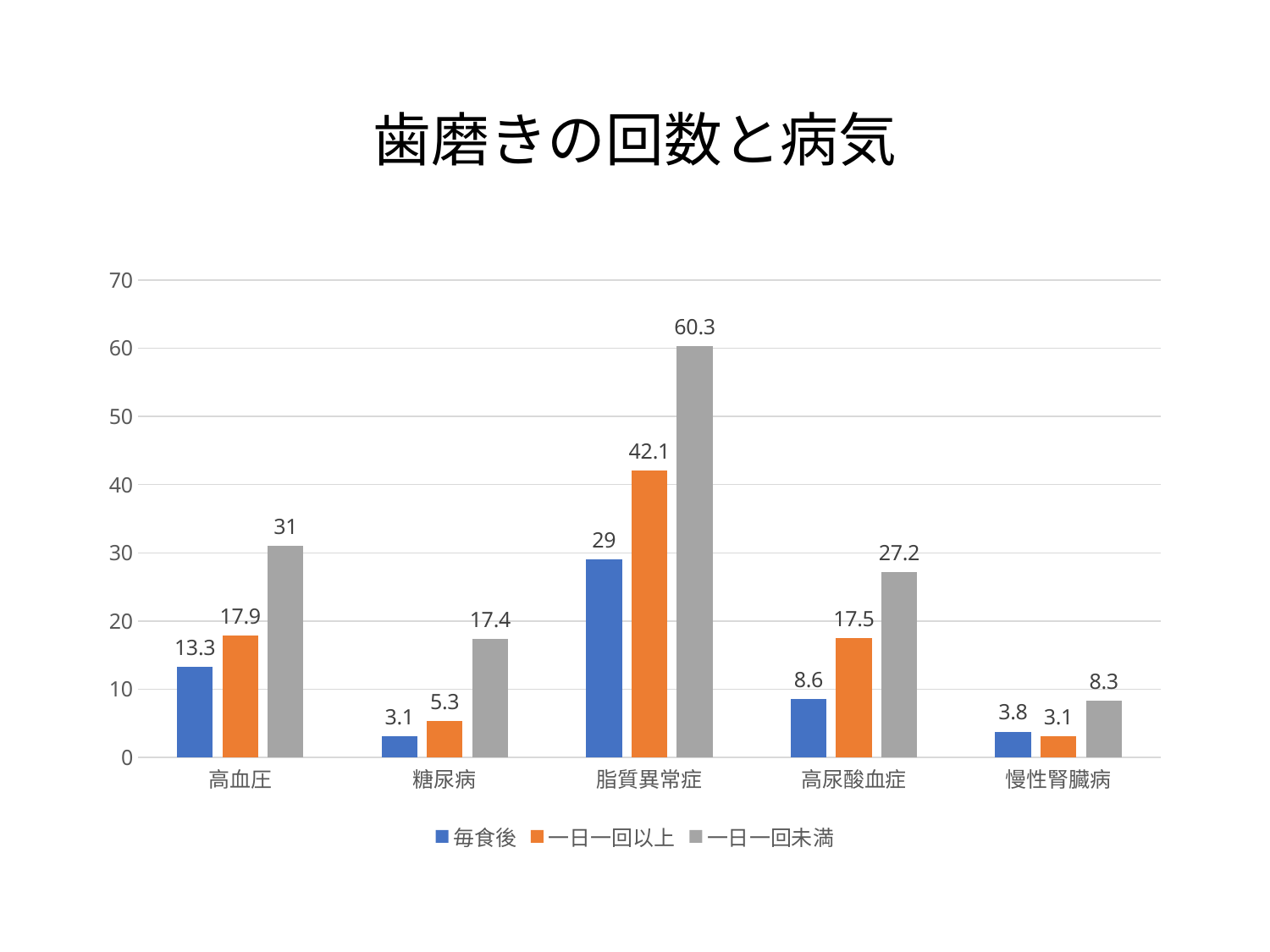
What is the title of the slide? 歯磨きの回数と病気 Which category has the lowest value for the 毎食後 series? 糖尿病 How many series does the legend list? 3 Which colour represents the 一日一回以上 series? orange What kind of chart is shown on the slide? bar chart What is the value for 一日一回以上 in the 高尿酸血症 category? 17.5 What is the value for 一日一回未満 in the 脂質異常症 category? 60.3 What is the difference between the 一日一回未満 and 毎食後 values in the 脂質異常症 category? 31.3 How many disease categories are shown on the x axis? 5 What is the value for 毎食後 in the 高血圧 category? 13.3 Which category has the highest value for the 一日一回未満 series? 脂質異常症 Which is larger in the 慢性腎臓病 category: the 毎食後 value or the 一日一回以上 value? 毎食後